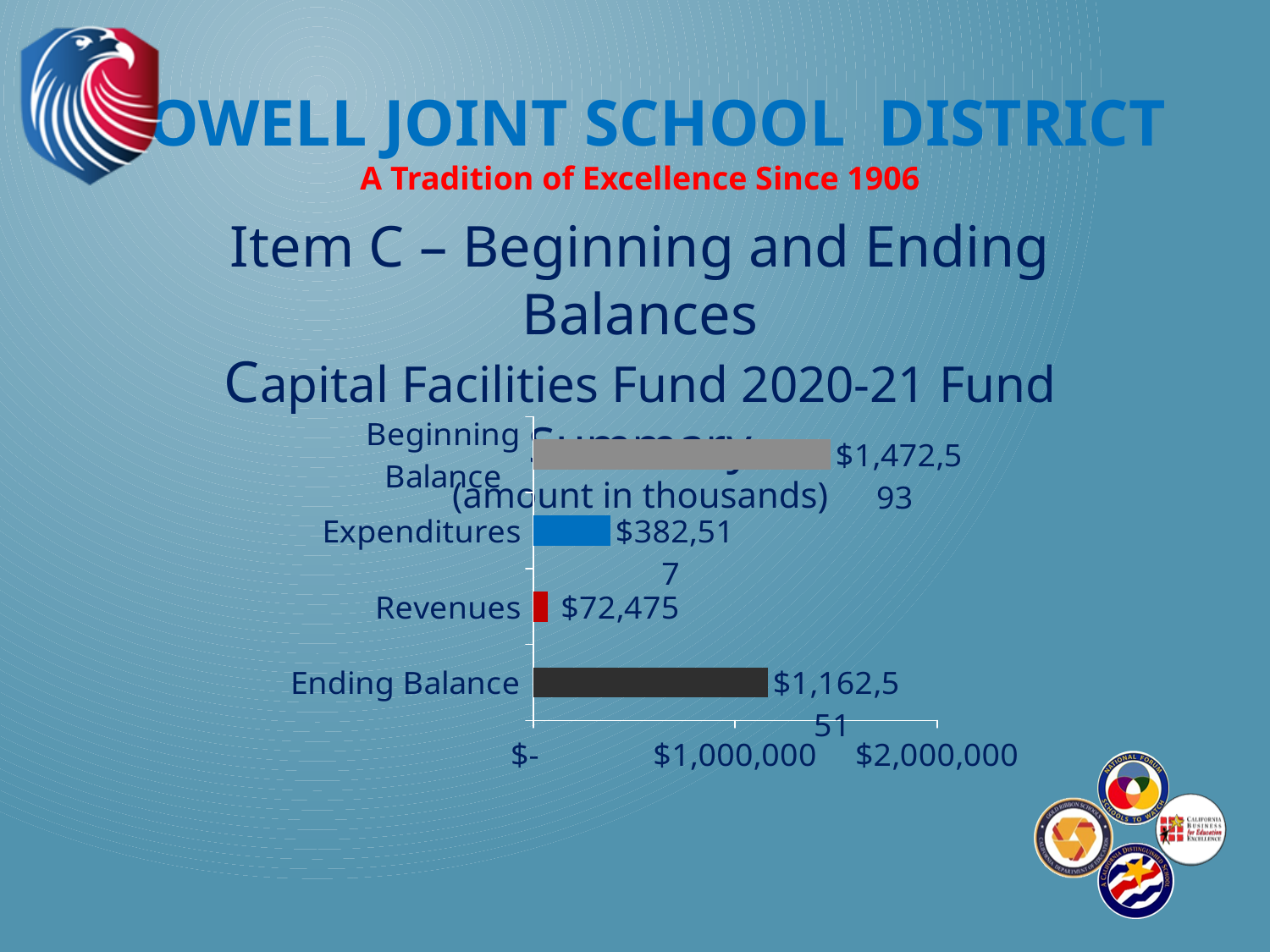
What is the difference between the Beginning Balance and the Ending Balance? $310,042 Is the value for Ending Balance greater or less than $1,000,000? greater How many categories are plotted in the chart? 4 What is the value shown for Revenues? $72,475 What is the value of the Beginning Balance bar? $1,472,593 Which category has the highest value? Beginning Balance What is the value of the Ending Balance bar? $1,162,551 What is the value shown for Expenditures? $382,517 Which is larger, the Beginning Balance or the Ending Balance? Beginning Balance Which is larger, Expenditures or Revenues? Expenditures What kind of chart is shown on the slide? Bar chart Which category has the lowest value? Revenues